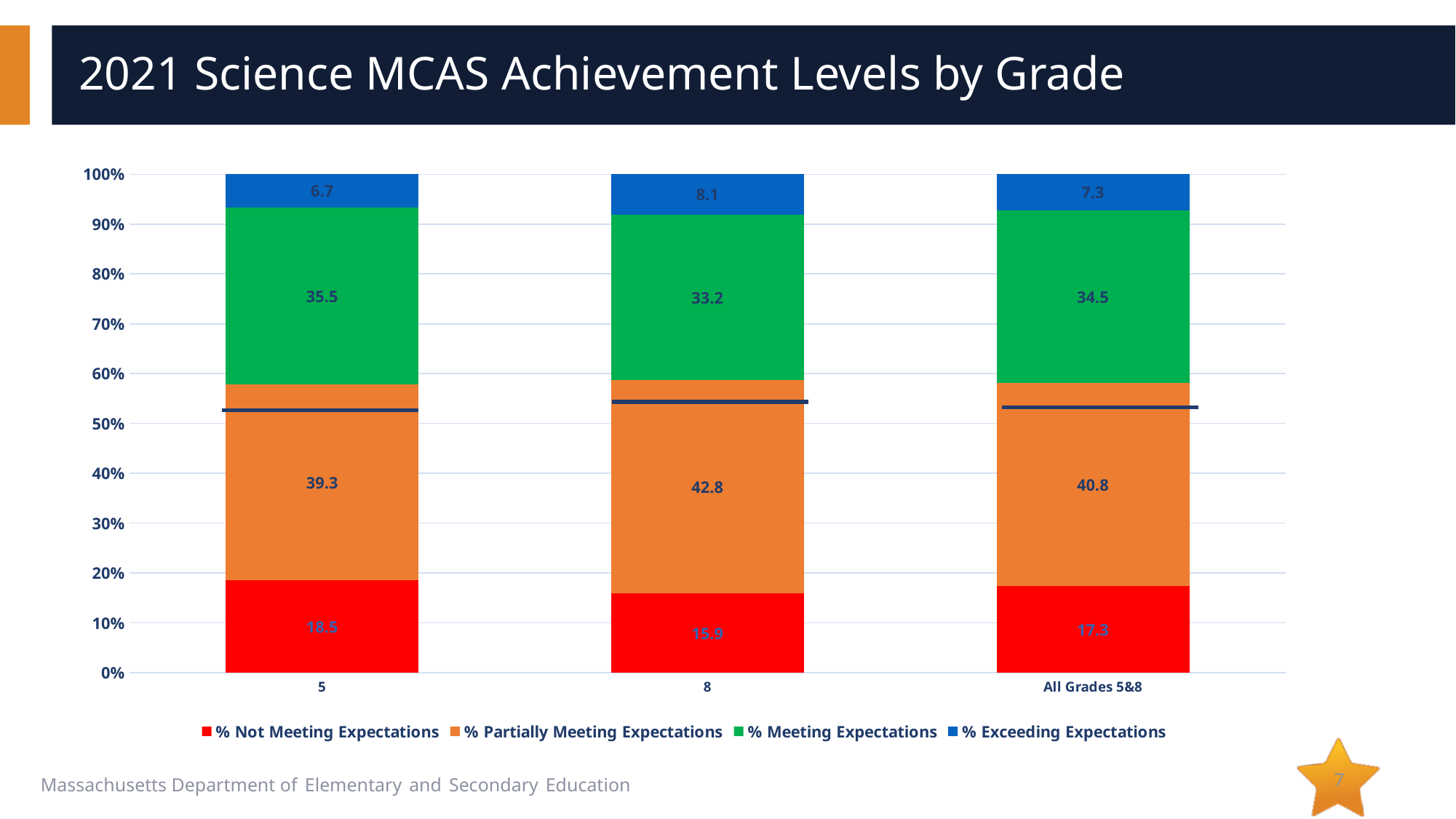
What kind of chart is shown on the slide? Stacked bar chart Which is larger, the % Partially Meeting Expectations value for grade 5 or for All Grades 5&8? All Grades 5&8 How many categories are shown on the x axis? 3 What is the % Partially Meeting Expectations value for grade 8? 42.8 Which category has the highest % Partially Meeting Expectations value? 8 What is the difference between the % Meeting Expectations values for grade 5 and grade 8? 2.3 How many series does the legend list? 4 Which category has the lowest % Not Meeting Expectations value? 8 What is the % Exceeding Expectations value for grade 8? 8.1 What is the % Not Meeting Expectations value for grade 5? 18.5 What is the title of the chart on the slide? 2021 Science MCAS Achievement Levels by Grade What is the % Meeting Expectations value for All Grades 5&8? 34.5